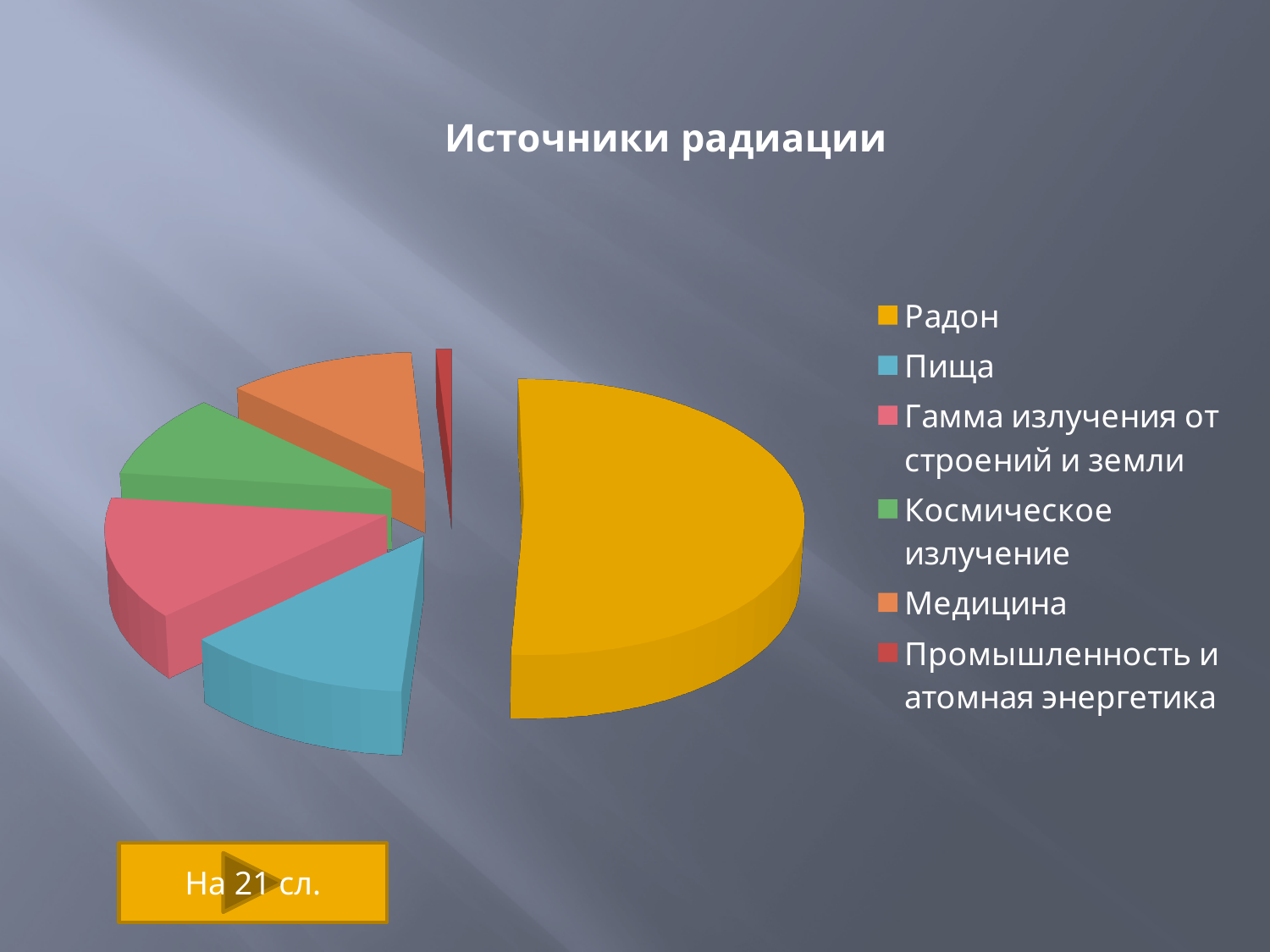
Which slice is larger, Пища or Промышленность и атомная энергетика? Пища What is the title of the chart? Источники радиации Which source of radiation has the smallest slice in the pie chart? Промышленность и атомная энергетика How many categories (slices) does the pie chart have? 6 Which slice is larger, Радон or Медицина? Радон Which source of radiation has the largest slice in the pie chart? Радон Which slice is larger, Космическое излучение or Промышленность и атомная энергетика? Космическое излучение What kind of chart is shown on the slide? pie chart Which category is listed first in the legend? Радон What colour is the slice for Радон? yellow